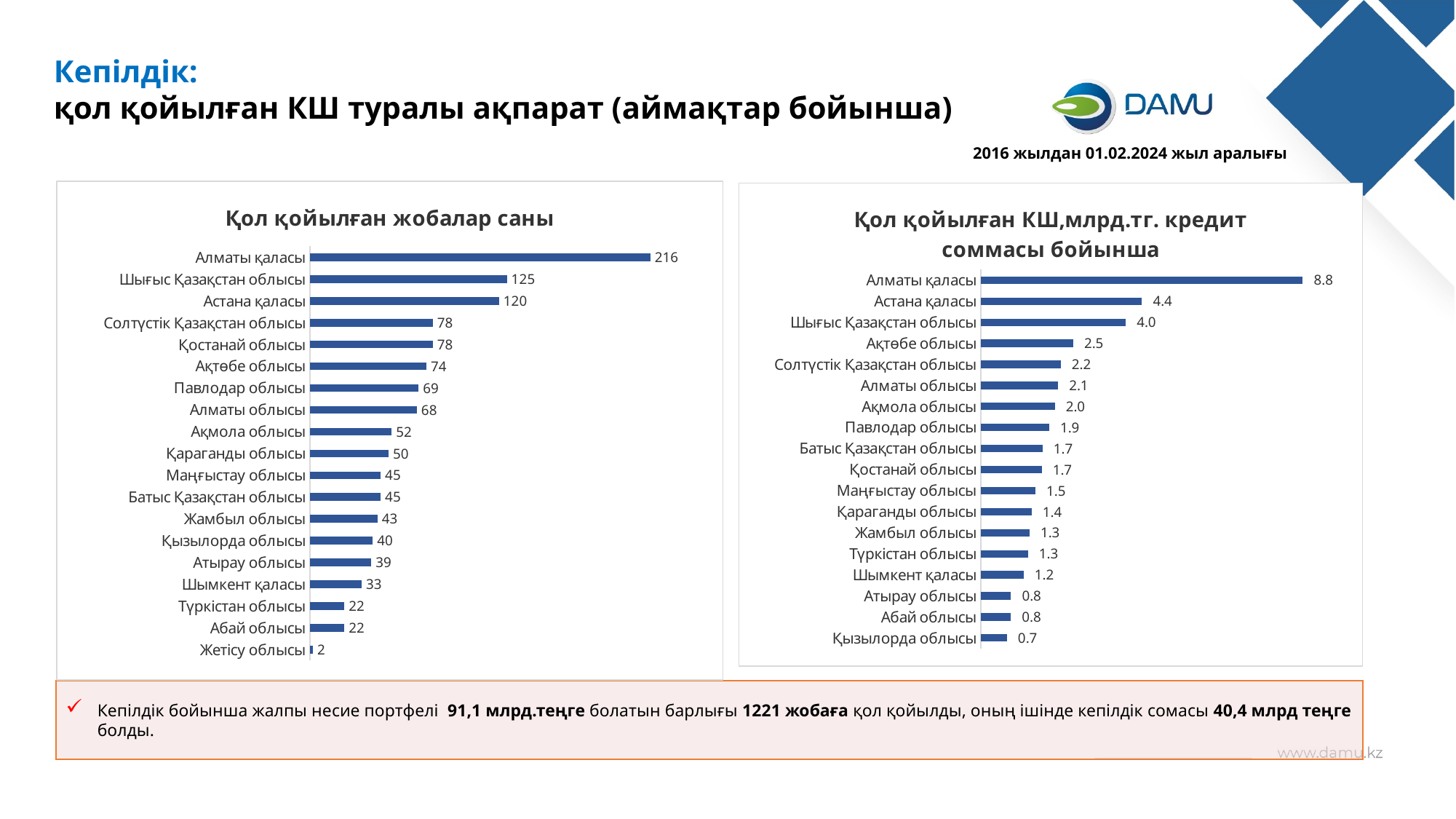
In the chart titled "Қол қойылған КШ,млрд.тг. кредит соммасы бойынша", what is the value for Ақтөбе облысы? 2.5 In the chart titled "Қол қойылған жобалар саны", what is the difference between the values for Алматы қаласы and Шығыс Қазақстан облысы? 91 In the chart titled "Қол қойылған жобалар саны", what is the value for Павлодар облысы? 69 In the chart titled "Қол қойылған жобалар саны", how many categories are shown? 19 In the chart titled "Қол қойылған КШ,млрд.тг. кредит соммасы бойынша", how many categories are shown? 18 In the chart titled "Қол қойылған жобалар саны", which category has the highest value? Алматы қаласы In the chart titled "Қол қойылған жобалар саны", what is the value for Астана қаласы? 120 What type of chart is the chart on the right side of the slide? Bar chart In the chart titled "Қол қойылған КШ,млрд.тг. кредит соммасы бойынша", which category has the lowest value? Қызылорда облысы In the chart titled "Қол қойылған жобалар саны", which category has the lowest value? Жетісу облысы In the chart titled "Қол қойылған КШ,млрд.тг. кредит соммасы бойынша", what is the difference between the values for Алматы қаласы and Астана қаласы? 4.4 In the chart titled "Қол қойылған КШ,млрд.тг. кредит соммасы бойынша", which is larger: the value for Астана қаласы or Шығыс Қазақстан облысы? Астана қаласы